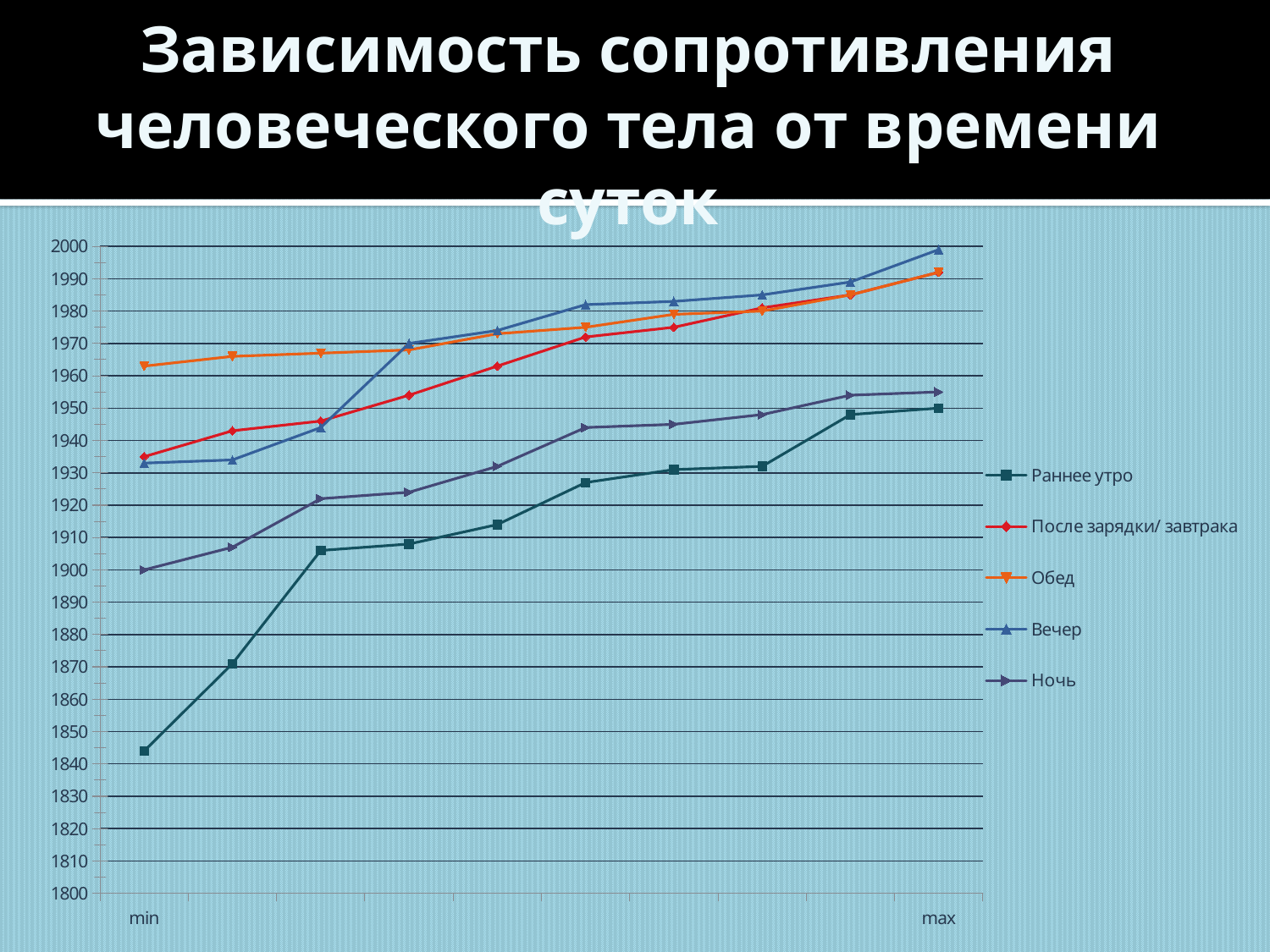
How many data points does the Раннее утро series have? 10 What is the value for Ночь at min? 1900 Do the values of the Раннее утро series rise or fall from min to max along the x axis? rise At min, which is larger: the value for Обед or the value for Раннее утро? Обед Which series has the highest value at max? Вечер Is the value for Вечер at max greater or less than 1990? greater Which series has the lowest value at min? Раннее утро How many series does the legend list? 5 What are the two labels shown on the x axis? min and max Is the value for Раннее утро at min greater or less than 1850? less Which series are listed in the legend? Раннее утро, После зарядки/ завтрака, Обед, Вечер, Ночь What kind of chart is shown on the slide? line chart